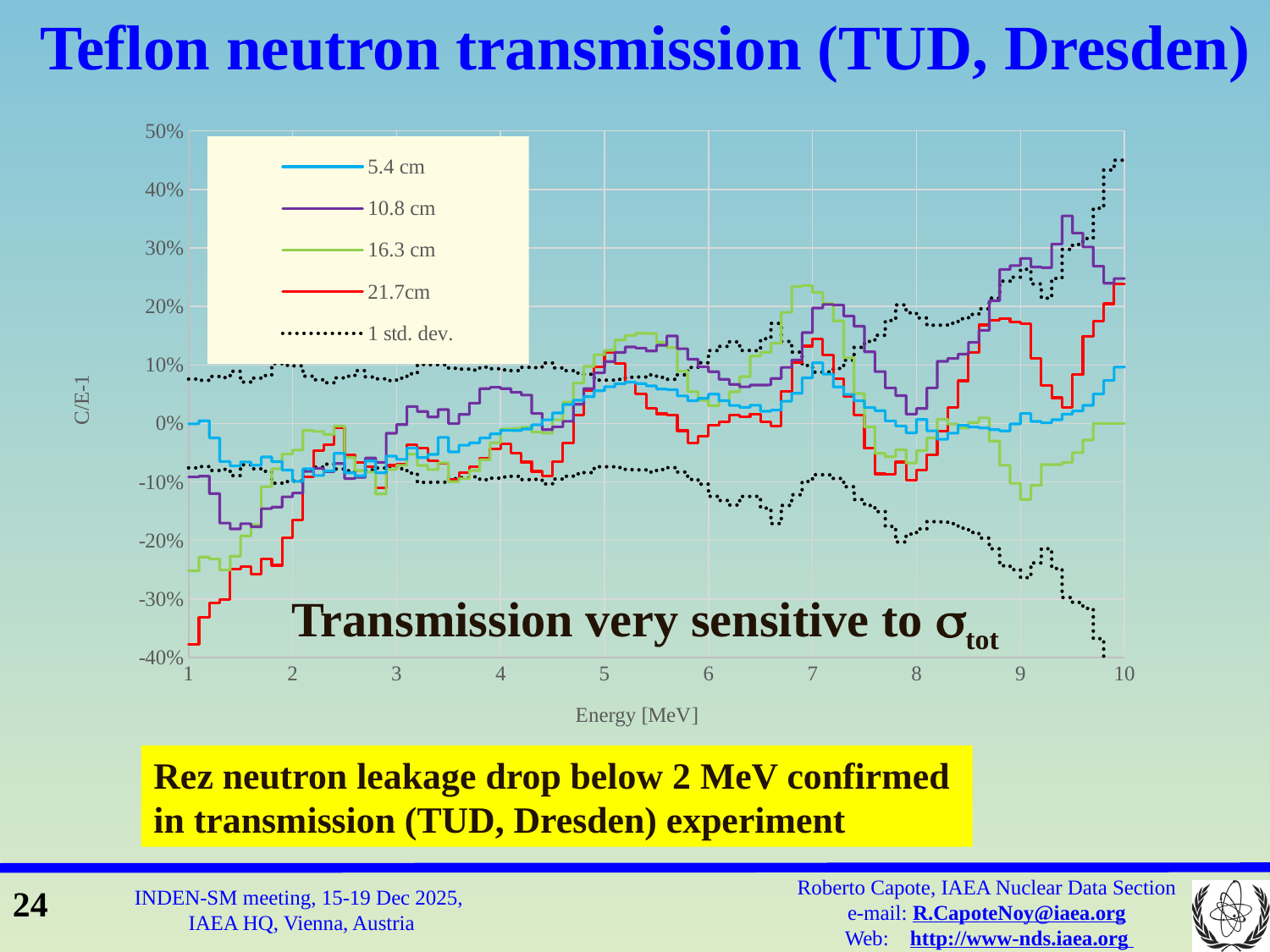
Is the value of the 21.7cm series at 1 MeV greater or less than -30%? less Is the peak value of the 10.8 cm series near 9.4 MeV greater or less than 30%? greater What is the label of the x axis? Energy [MeV] Is the value of the 21.7cm series at 10 MeV greater or less than 20%? greater At 1 MeV, which series has the higher value, 5.4 cm or 21.7cm? 5.4 cm How many series does the legend list? 5 Among the four thickness series, which one reaches the lowest value on the chart? 21.7cm What kind of chart is shown on the slide? line chart What is the label of the y axis? C/E-1 Does the 21.7cm series generally rise or fall from 1 MeV to 10 MeV? rise